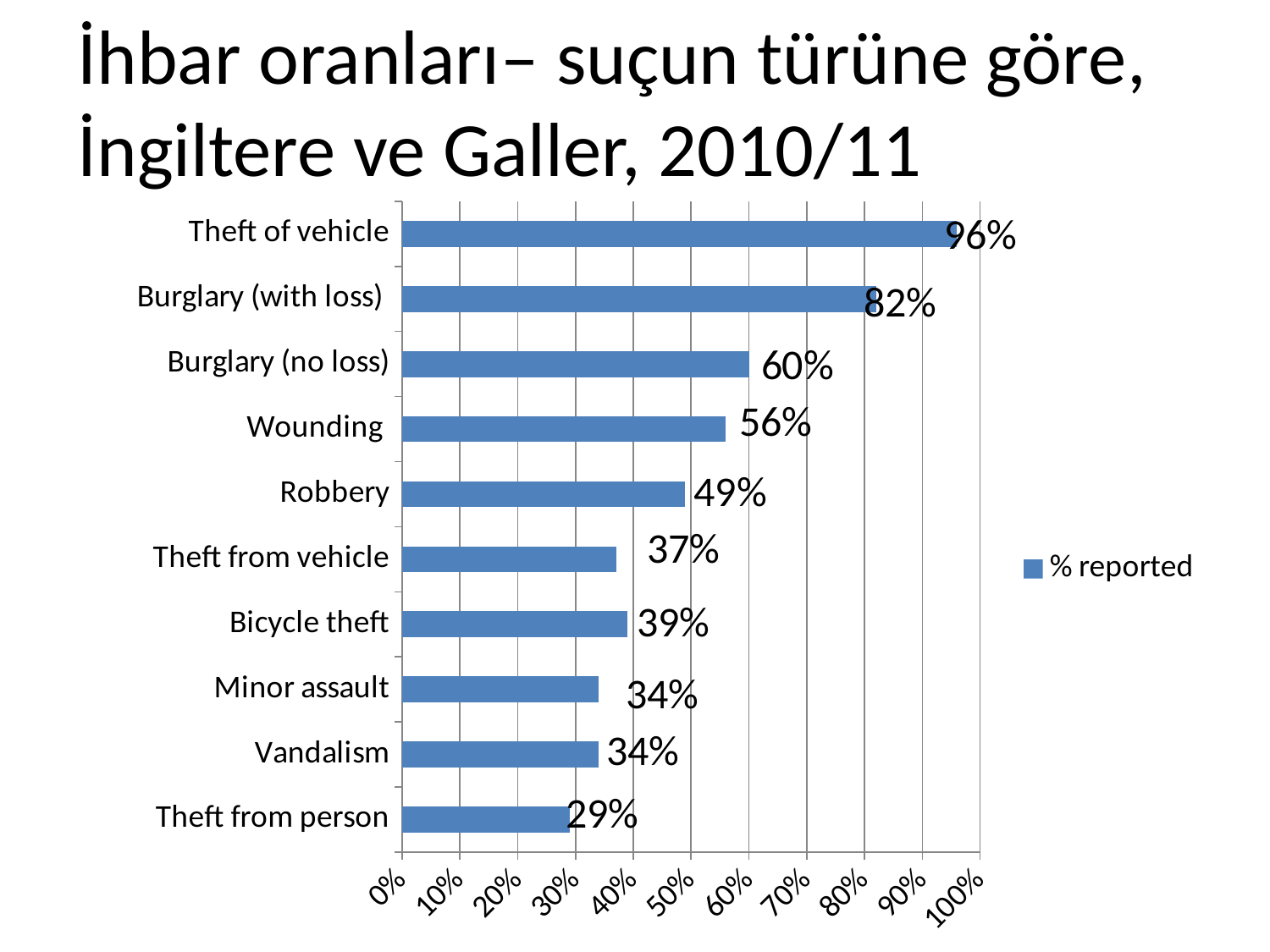
Which crime type has the lowest % reported? Theft from person How many crime types are shown in the chart? 10 What is the difference in % reported between Burglary (with loss) and Burglary (no loss)? 22% What is the legend entry for the series in the chart? % reported Which crime type has the highest % reported? Theft of vehicle Which has a higher % reported, Robbery or Theft from vehicle? Robbery Is the value for Minor assault greater or less than 50%? less What is the % reported value for Wounding? 56% What is the % reported value for Theft of vehicle? 96% What kind of chart is shown on the slide? bar chart What is the % reported value for Bicycle theft? 39% How many series does the legend list? 1